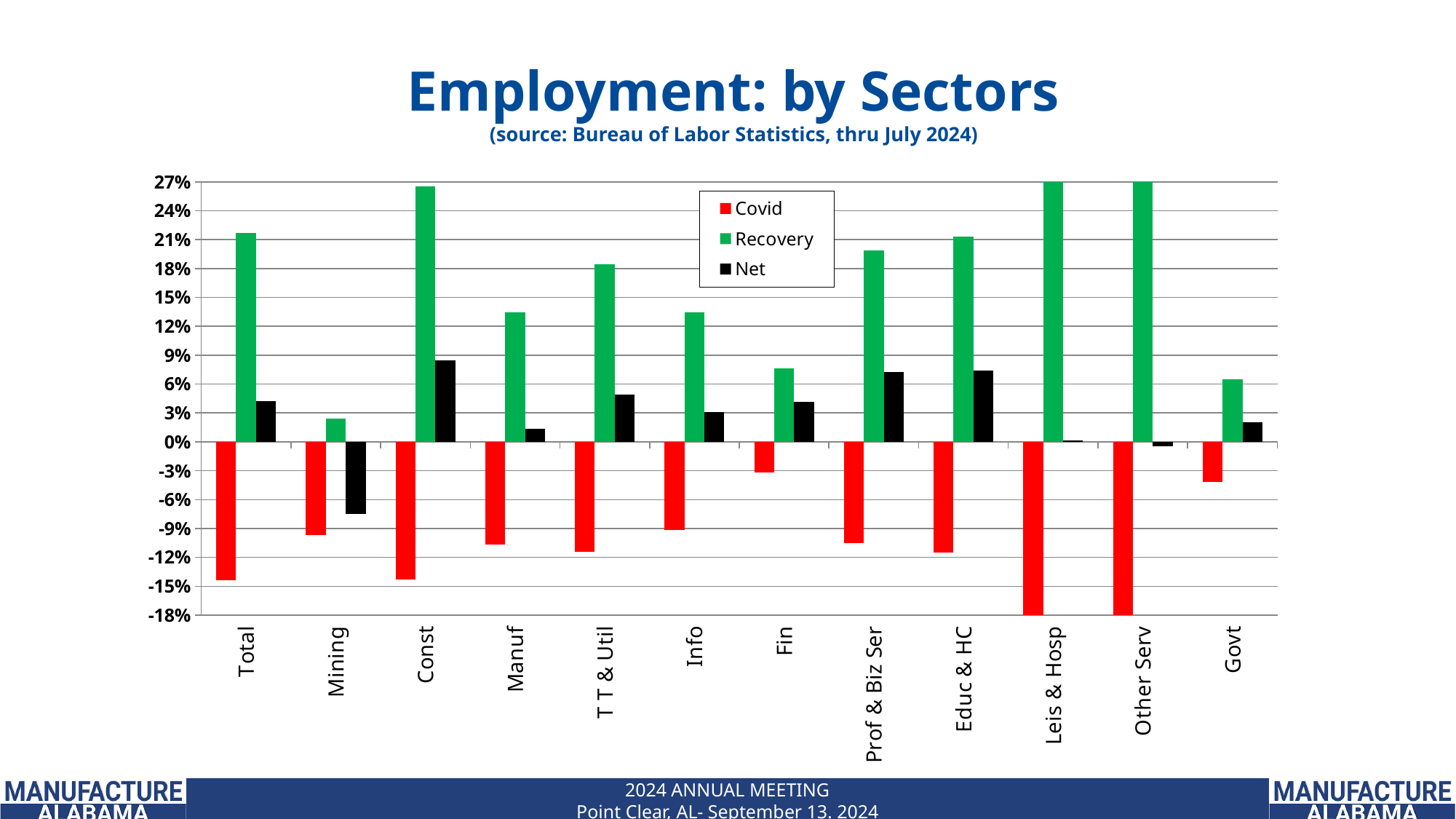
Which sector has the smallest Recovery value? Mining Is the Net value for Mining greater or less than -6%? less Which sector has the smallest Covid decline (the Covid bar closest to zero)? Fin How many series does the legend list? 3 Is the Recovery value for Const greater or less than 24%? greater What colour are the Recovery bars? green Which has the larger Net value, Const or Manuf? Const Is the Covid value for Total greater or less than -12%? less How many sector categories are shown on the x axis? 12 Which sector has the lowest Net value? Mining What kind of chart is shown on the slide? bar chart Which has the larger Recovery value, Total or Manuf? Total